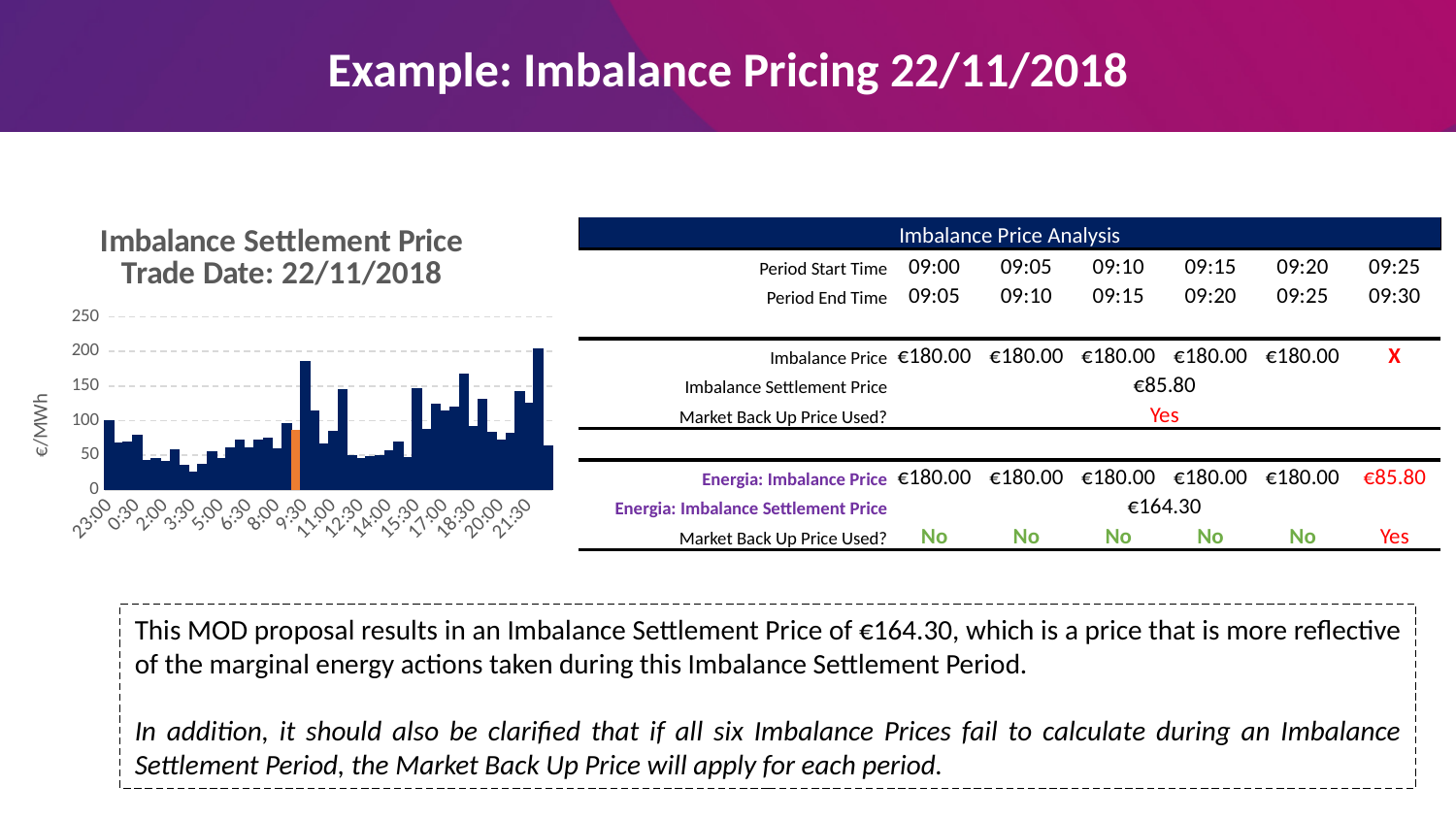
How many time labels are shown along the x-axis of the chart? 16 What unit is shown on the y-axis of the chart? €/MWh What kind of chart is shown on the slide? Bar chart What is the first time label on the x-axis of the chart? 23:00 Is the value of the orange highlighted bar in the chart greater or less than 50? greater What is the title of the chart on the slide? Imbalance Settlement Price Trade Date: 22/11/2018 What is the highest value shown on the y-axis of the chart? 250 Is the value of the tallest bar in the chart greater or less than 150? greater Do any bars in the chart reach the 250 gridline? No What is the last time label on the x-axis of the chart? 21:30